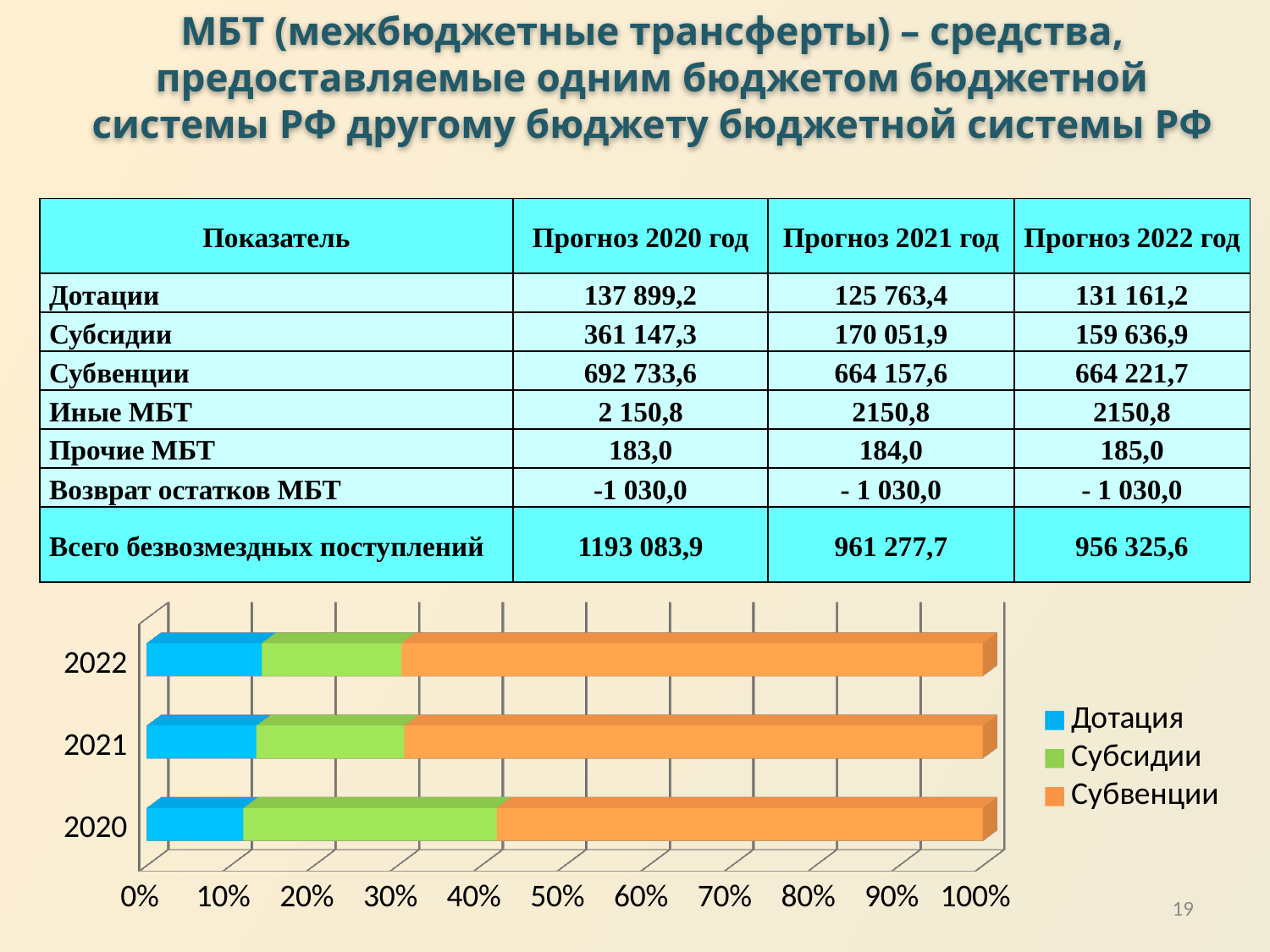
In the bar chart, does the Субсидии share rise or fall from 2020 to 2022? fall In the bar chart, is the Субвенции share for 2022 greater or less than 50%? greater Which series is shown in blue in the bar chart? Дотация In the bar chart, is the Субвенции share larger in 2020 or in 2022? 2022 How many series does the legend of the bar chart list? 3 How many years (categories) are plotted on the bar chart? 3 What kind of chart is shown at the bottom of the slide? Stacked bar chart In the bar chart, which year has the largest Субсидии share? 2020 In the bar chart, is the Субсидии share larger in 2020 or in 2022? 2020 In the bar chart, is the Дотация share for 2020 greater or less than 20%? less In the bar chart, is the combined share of Дотация and Субсидии for 2020 greater or less than 50%? less Which series is shown in orange in the bar chart? Субвенции